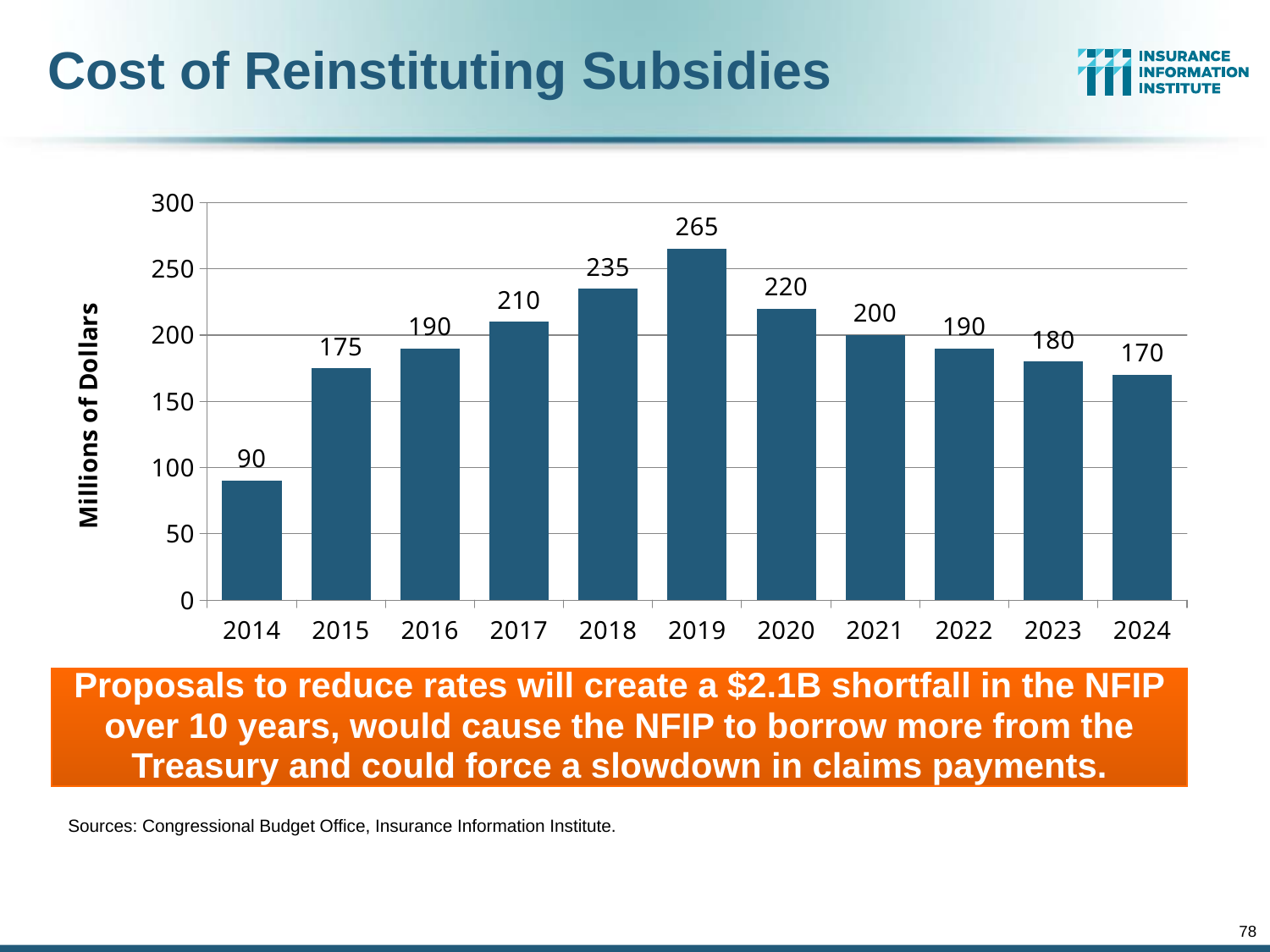
Which year has the highest value? 2019 Which year has the lowest value? 2014 What is the label on the vertical axis? Millions of Dollars What is the value for 2014? 90 How many years are shown on the x axis? 11 What is the difference between the values for 2019 and 2014? 175 What kind of chart is shown on the slide? Bar chart Which is larger, the value for 2017 or the value for 2021? 2017 What is the difference between the values for 2018 and 2020? 15 What is the value for 2019? 265 What is the value for 2024? 170 Do the values rise or fall from 2019 to 2024? Fall